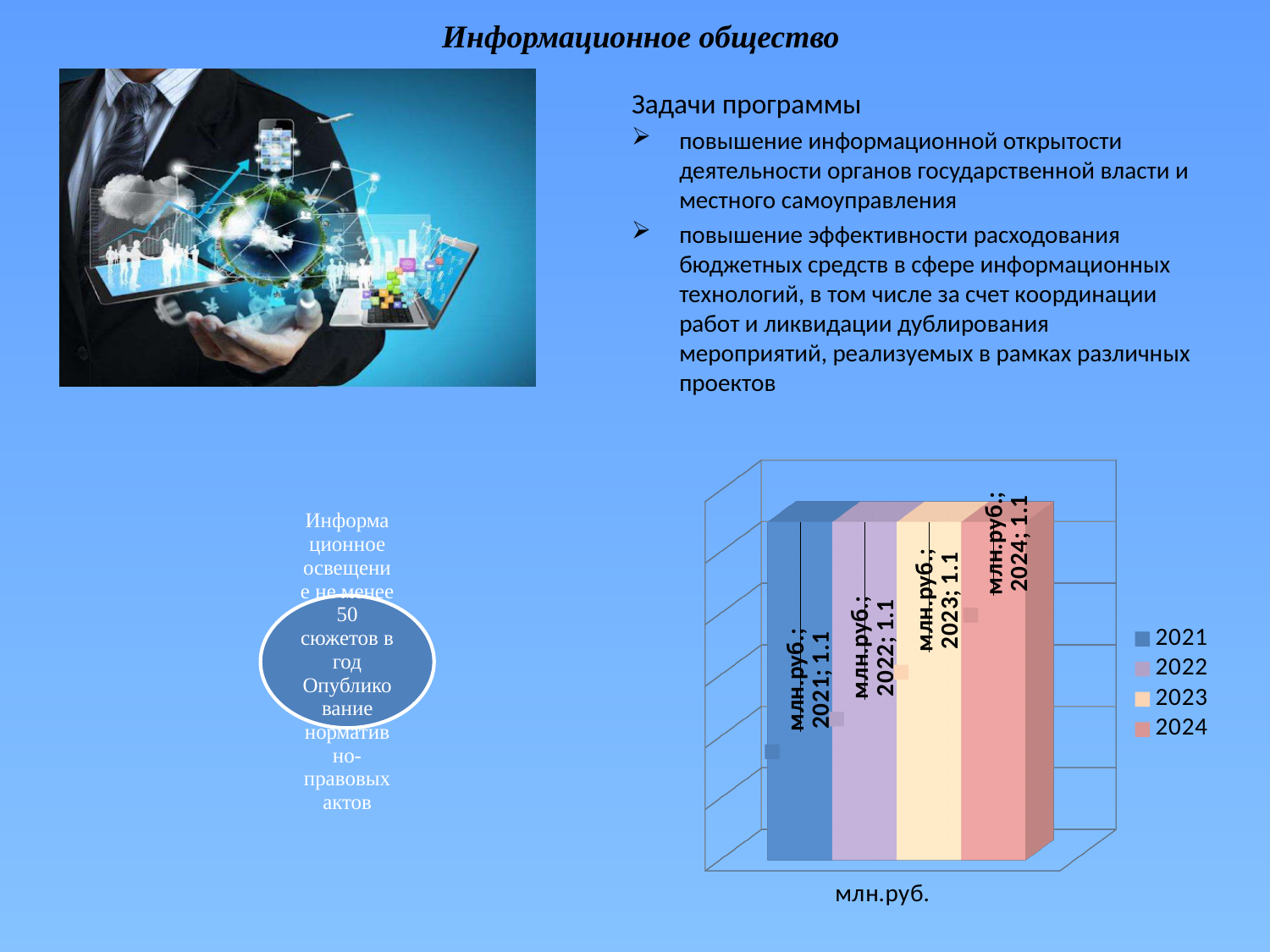
Do the values change from the 2021 series to the 2024 series in the chart? No, they stay the same What is the difference between the 2024 value and the 2021 value in the chart? 0 How many series does the chart legend list? 4 Which years are listed in the chart legend? 2021, 2022, 2023, 2024 What is the value for the 2022 series in the chart? 1.1 What is the value for the 2023 series in the chart? 1.1 What is the value for the 2021 series in the chart? 1.1 What is the value for the 2024 series in the chart? 1.1 How many categories are shown on the chart's horizontal axis? 1 What is the category label shown below the chart's bars? млн.руб. What type of chart is shown on the slide? bar chart